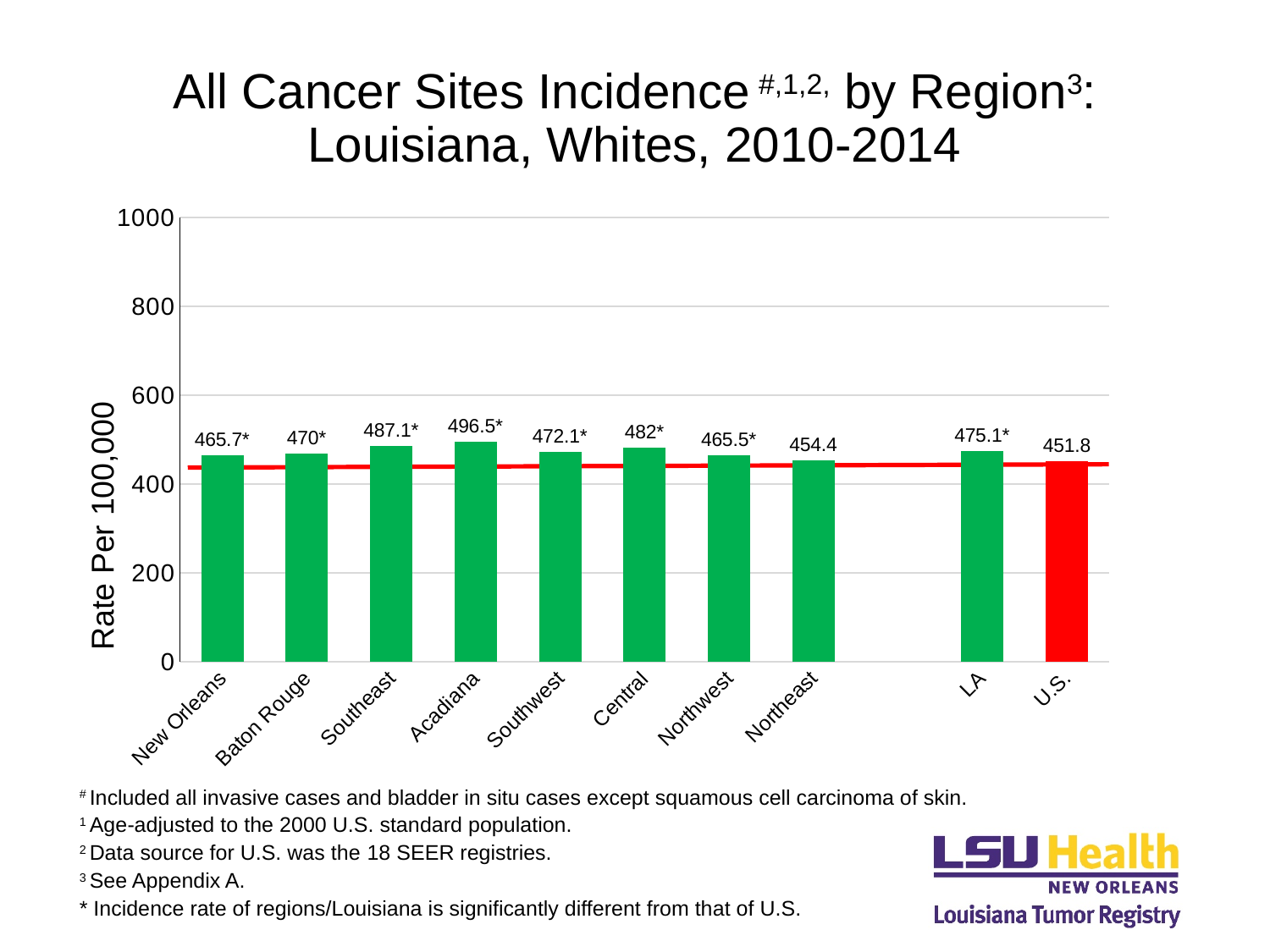
Which has a higher incidence rate, Baton Rouge or Northwest? Baton Rouge Which region has the highest incidence rate? Acadiana What is the difference between the Southeast rate and the Central rate? 5.1 What is the incidence rate for the U.S.? 451.8 What kind of chart is shown on the slide? bar chart What is the incidence rate for Northeast? 454.4 What is the incidence rate for LA? 475.1* How many bars are shown in the chart? 10 What is the difference between the Acadiana rate and the U.S. rate? 44.7 Is the value for Northeast greater or less than 400? greater Which bar has the lowest incidence rate? U.S. What is the incidence rate for Acadiana? 496.5*